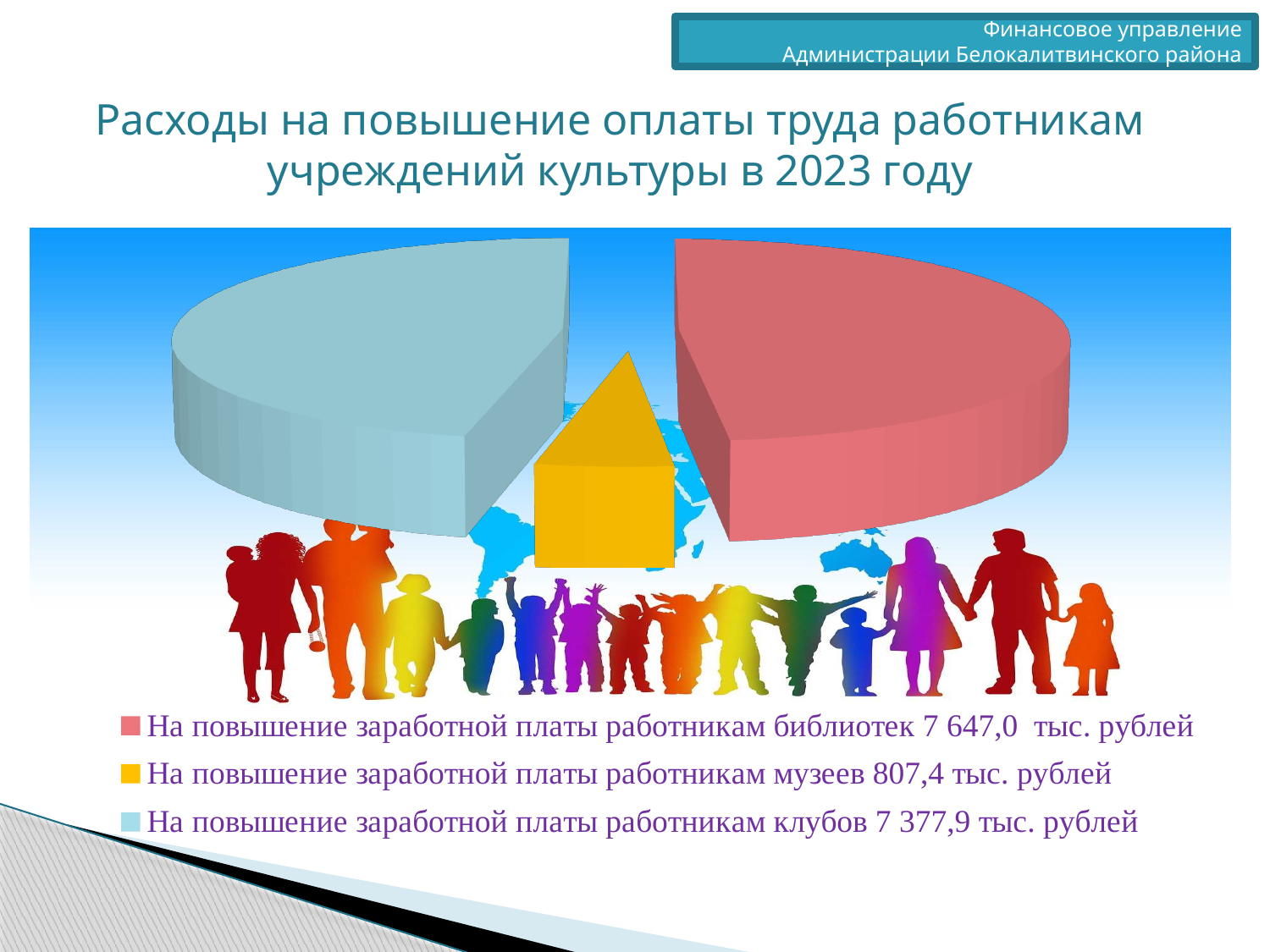
What kind of chart is shown on the slide? Pie chart How many entries does the legend list? 3 What is the difference between the value for club workers and the value for museum workers? 6 570,5 тыс. рублей Which category has the largest value? На повышение заработной платы работникам библиотек What is the value for raising the wages of museum workers (работникам музеев)? 807,4 тыс. рублей How many slices does the pie chart have? 3 What is the value for raising the wages of club workers (работникам клубов)? 7 377,9 тыс. рублей What is the difference between the value for library workers and the value for club workers? 269,1 тыс. рублей What is the value for raising the wages of library workers (работникам библиотек)? 7 647,0 тыс. рублей Which is larger: the value for library workers or the value for club workers? Library workers (работникам библиотек) Which category has the smallest value? На повышение заработной платы работникам музеев What colour is the slice for museum workers (работникам музеев)? Yellow